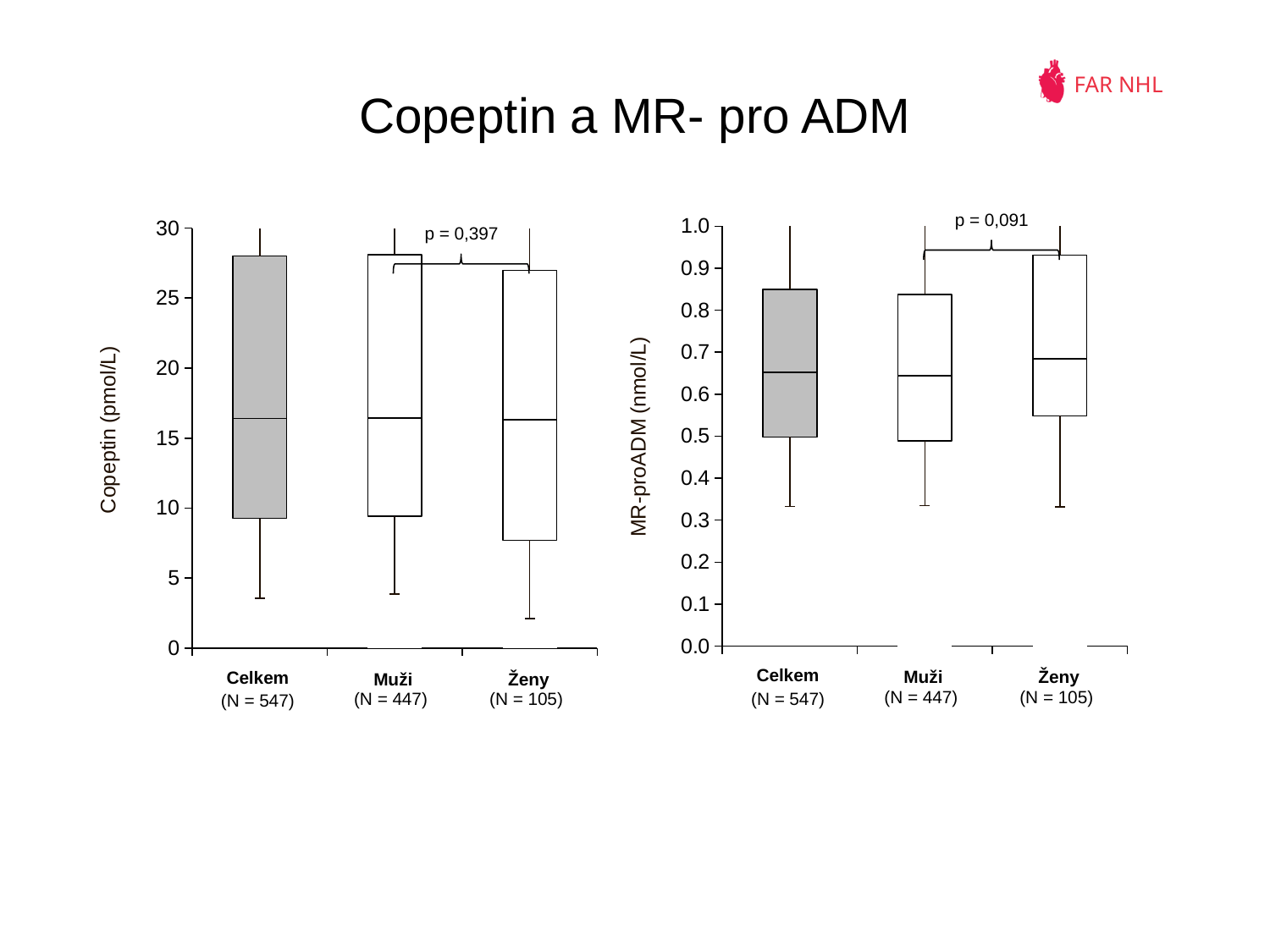
On the right chart, is the lower whisker of the Muži box greater or less than 0.4? less How many groups are shown on the x axis of the right chart (MR-proADM)? 3 On the left chart (Copeptin), what is the N for the Muži group? N = 447 On the left chart (Copeptin), what p-value is shown for the comparison between Muži and Ženy? p = 0,397 On the right chart (MR-proADM), what p-value is shown for the comparison between Muži and Ženy? p = 0,091 On the right chart (MR-proADM), what is the N for the Ženy group? N = 105 On the right chart, is the median MR-proADM value for Celkem greater or less than 0.6? greater On the left chart, is the median Copeptin value for Celkem greater or less than 15? greater How many groups are shown on the x axis of the left chart (Copeptin)? 3 What is the y-axis label of the right chart? MR-proADM (nmol/L) What kind of chart is the left chart (Copeptin)? box plot